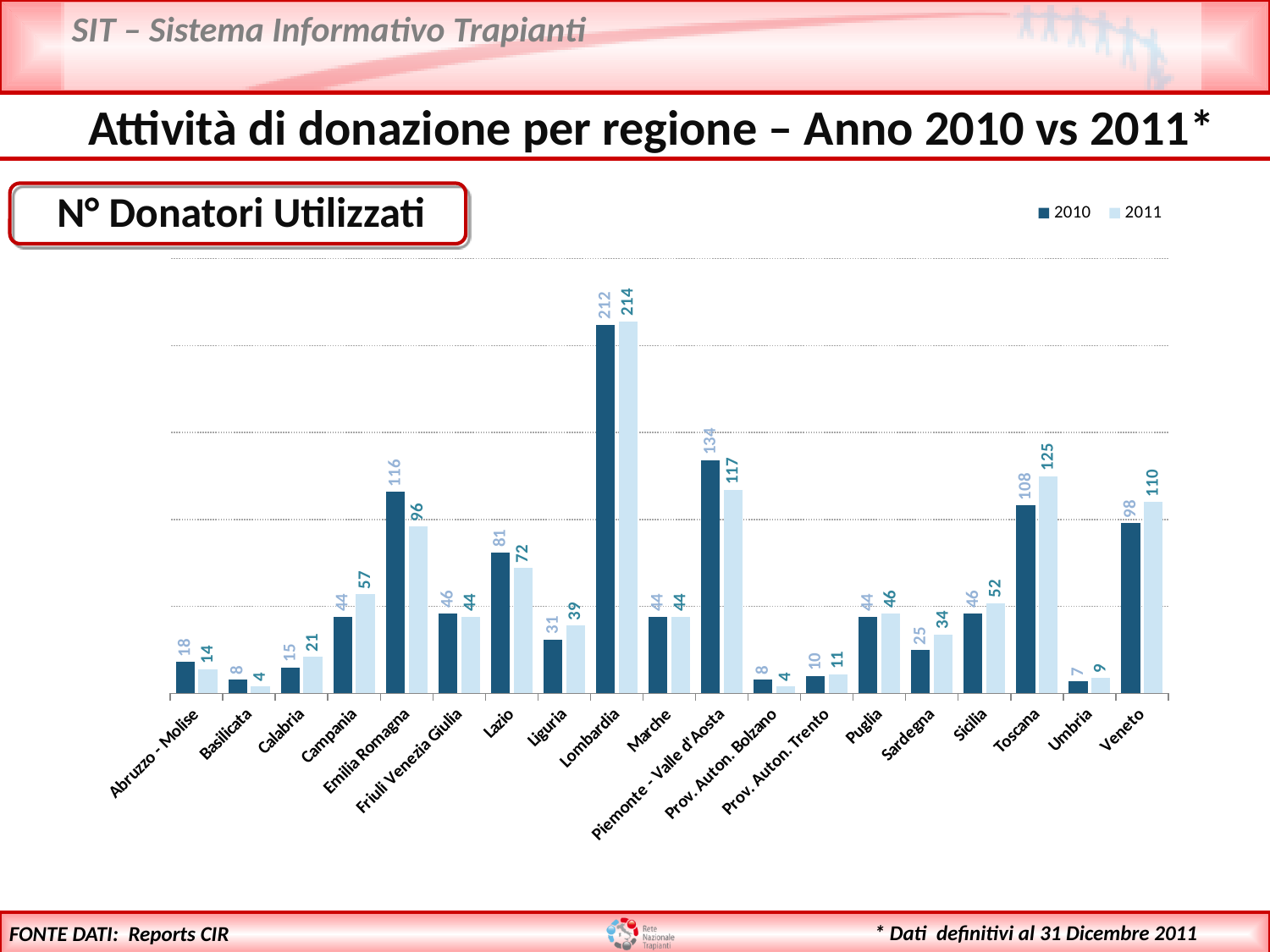
Which is larger for Lazio, the 2010 value or the 2011 value? 2010 Which region has the highest 2011 value? Lombardia How many regions are shown on the x axis? 19 What is the 2011 value for Campania? 57 What kind of chart is shown on the slide? Bar chart How many series does the legend list? 2 Which region has the lowest 2010 value? Umbria Which is larger for Veneto, the 2010 value or the 2011 value? 2011 What is the difference between the 2010 and 2011 values for Piemonte - Valle d'Aosta? 17 What is the 2010 value for Emilia Romagna? 116 What is the 2011 value for Toscana? 125 What is the title shown in the box above the chart? N° Donatori Utilizzati